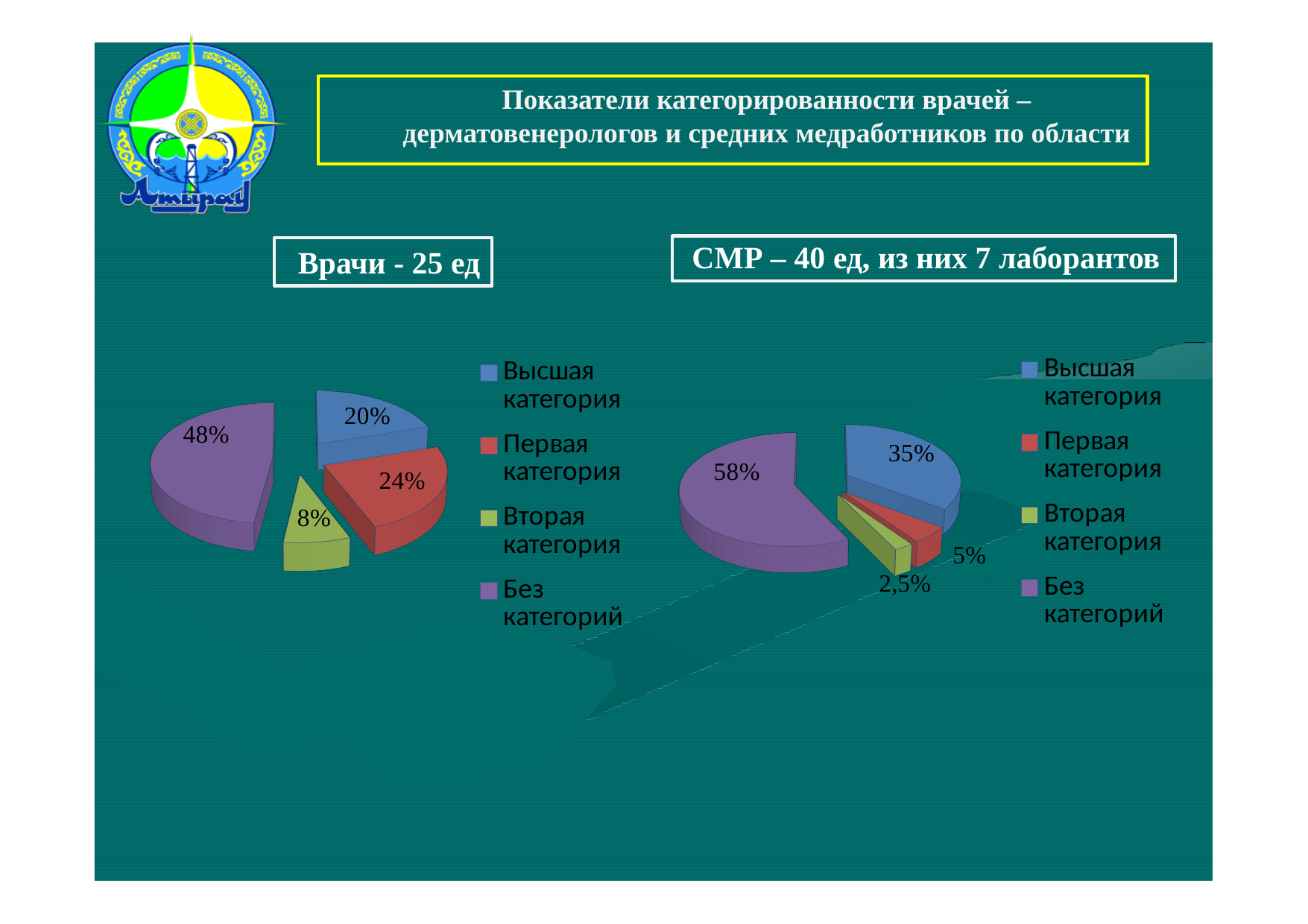
What type of chart is used on the left side of the slide (Врачи - 25 ед)? Pie chart In the left pie chart (Врачи - 25 ед), what share is labelled for Без категорий? 48% In the right pie chart (СМР – 40 ед), what share is labelled for Вторая категория? 2,5% In the left pie chart (Врачи - 25 ед), what share is labelled for Высшая категория? 20% In the right pie chart (СМР – 40 ед), what share is labelled for Первая категория? 5% In the left pie chart (Врачи - 25 ед), what is the difference between the shares for Первая категория and Высшая категория? 4% In the left pie chart (Врачи - 25 ед), which category has the largest slice? Без категорий In the right pie chart (СМР – 40 ед), which is larger: the share for Высшая категория or the share for Без категорий? Без категорий In the right pie chart (СМР – 40 ед), which category has the smallest slice? Вторая категория In the left pie chart (Врачи - 25 ед), which colour represents Без категорий? Purple In the left pie chart (Врачи - 25 ед), which category has the smallest slice? Вторая категория How many slices does the right pie chart (СМР – 40 ед) have? 4